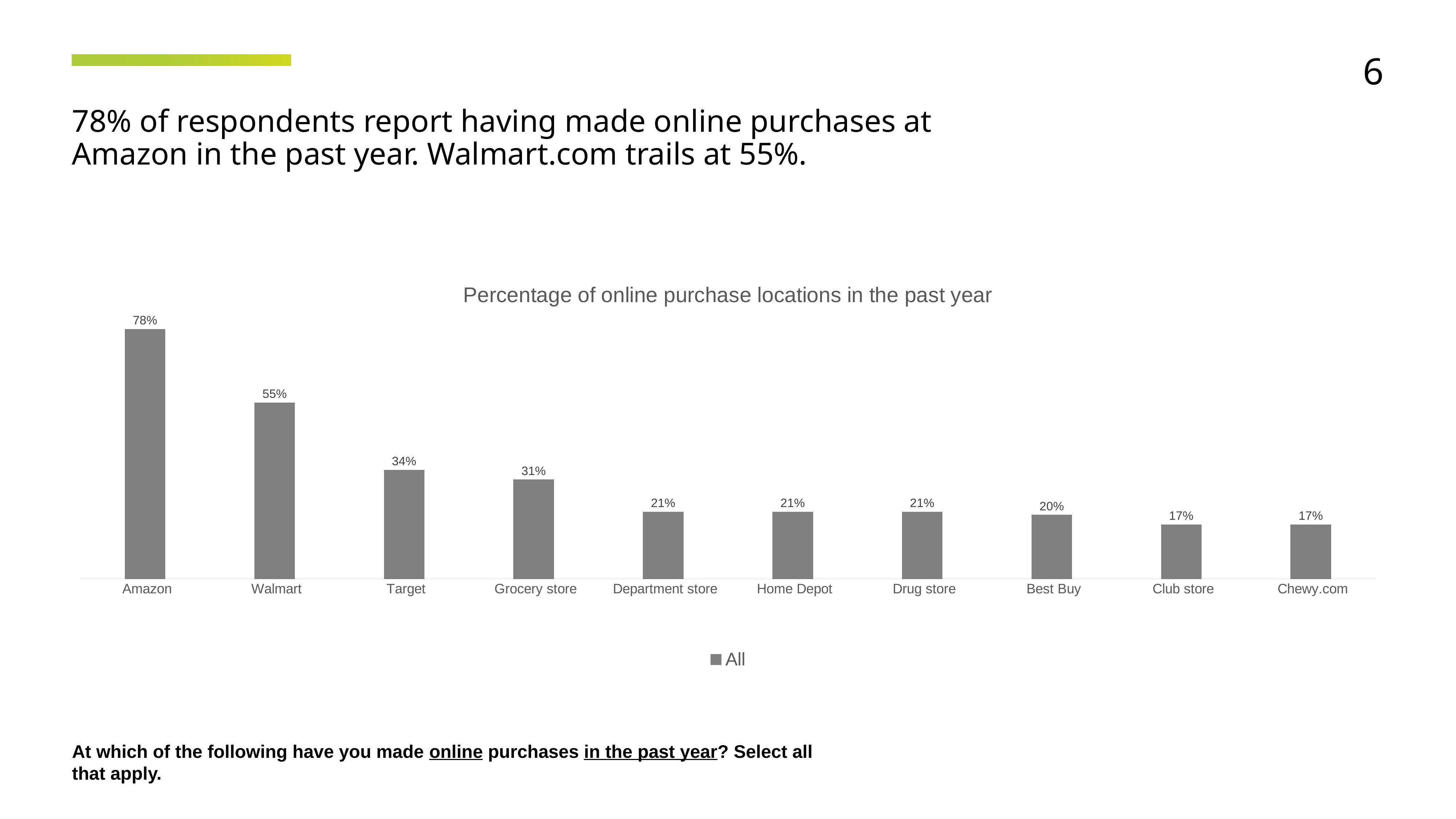
How many series does the legend list? 1 What is the value shown for Grocery store? 31% What is the value shown for Target? 34% What kind of chart is shown on the slide? Bar chart What is the difference between the values for Amazon and Walmart? 23% What is the value shown for Best Buy? 20% Which category has the highest value? Amazon What is the difference between the values for Target and Grocery store? 3% How many categories are shown on the x axis? 10 What percentage of respondents made online purchases at Amazon in the past year? 78% What is the title of the chart? Percentage of online purchase locations in the past year Which is larger, the value for Walmart or the value for Target? Walmart